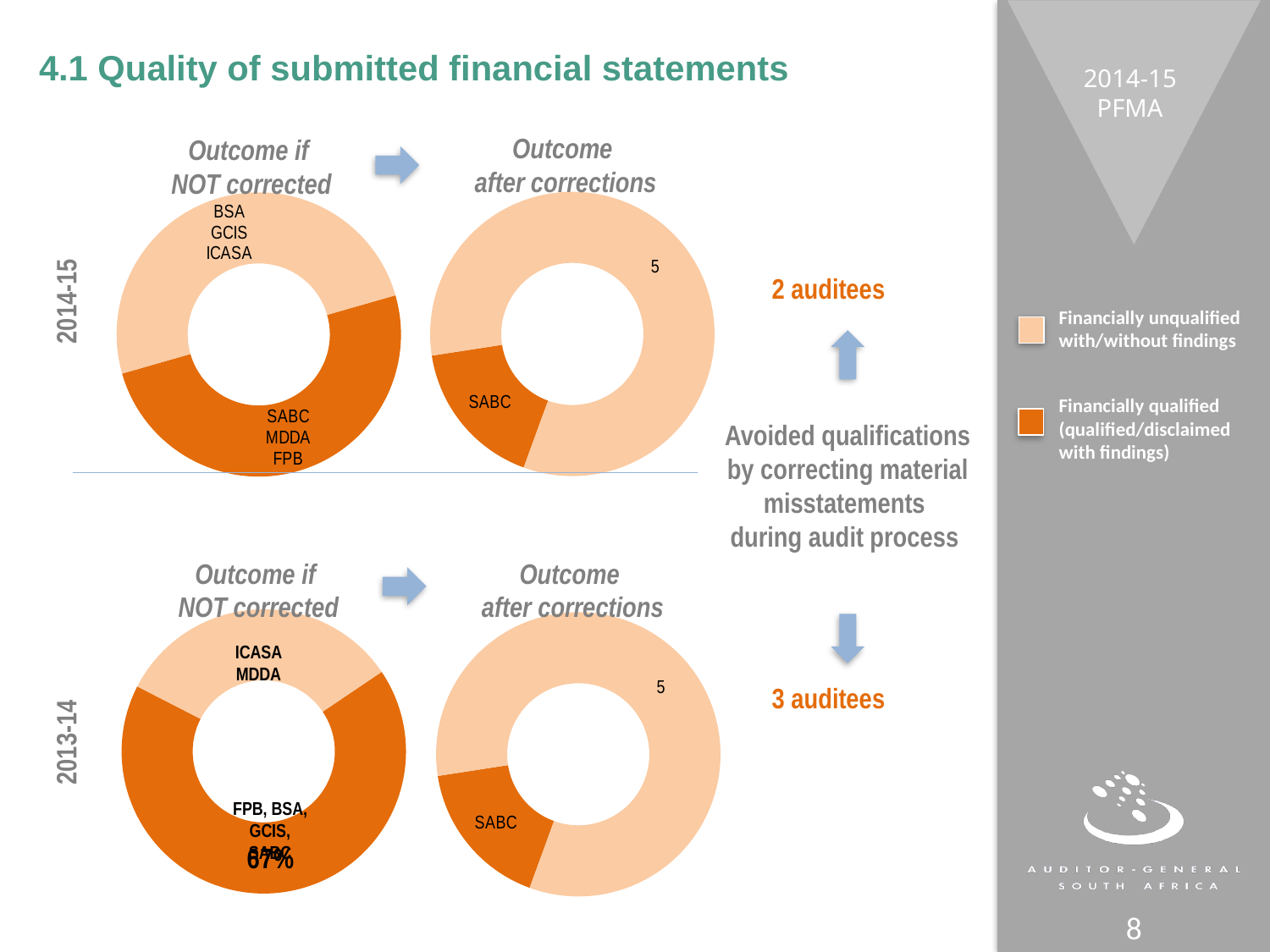
How many segments does each donut chart on the slide have? 2 In the 2013-14 'Outcome if NOT corrected' chart, which auditees are labelled on the light-coloured (financially unqualified) segment? ICASA, MDDA In the 2014-15 'Outcome if NOT corrected' chart, which auditees are labelled on the light-coloured (financially unqualified) segment? BSA, GCIS, ICASA What kind of chart is used for the 2014-15 'Outcome if NOT corrected' visual? Donut (pie) chart In the 2014-15 'Outcome if NOT corrected' chart, which auditees are labelled on the orange (financially qualified) segment? SABC, MDDA, FPB In the 2013-14 'Outcome if NOT corrected' chart, what percentage is printed on the orange (financially qualified) segment? 67% In the 2013-14 'Outcome if NOT corrected' chart, which segment is larger: the orange (financially qualified) or the light (financially unqualified) segment? Orange (financially qualified) In the 2014-15 'Outcome after corrections' chart, which auditee is labelled on the orange (financially qualified) segment? SABC How many categories does the legend on the right of the slide list? 2 In the 2014-15 'Outcome after corrections' chart, what value is printed on the light-coloured (financially unqualified) segment? 5 In the 2014-15 'Outcome after corrections' chart, which segment is larger: the light (financially unqualified) or the orange (financially qualified) segment? Light (financially unqualified) In the 2013-14 'Outcome after corrections' chart, what value is printed on the light-coloured (financially unqualified) segment? 5